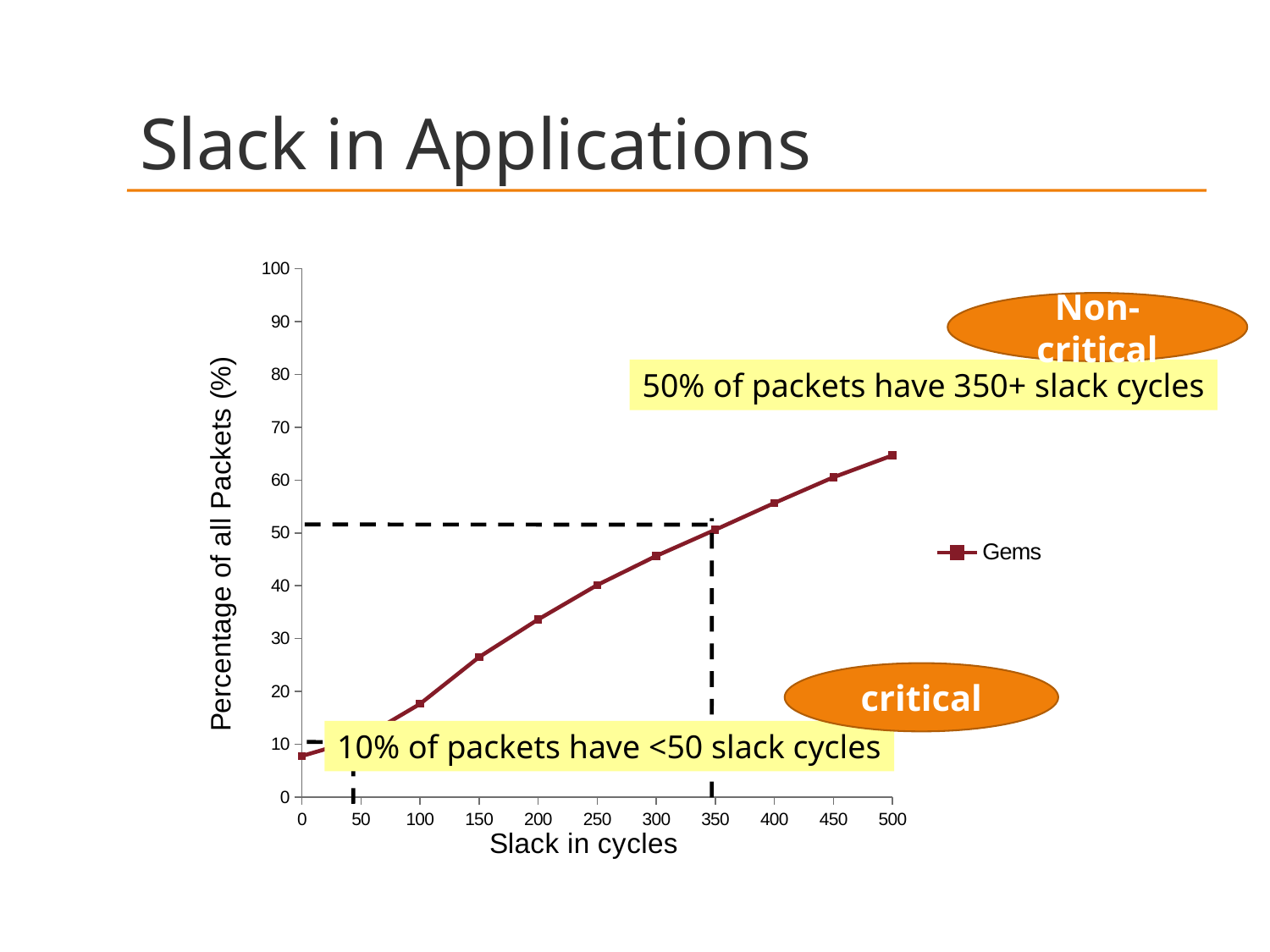
Is the value for Gems at 150 slack cycles greater or less than 30? less Is the value for Gems at 200 slack cycles greater or less than 30? greater Is the value for Gems at 500 slack cycles greater or less than 60? greater What is the name of the series shown in the legend? Gems At which slack value is the Gems series lowest? 0 Do the values of the Gems series rise or fall as slack in cycles increases? rise What kind of chart is shown on the slide? line chart At which slack value is the Gems series highest? 500 What is the title of the x axis? Slack in cycles How many series does the legend list? 1 Which is larger for Gems: the value at 400 slack cycles or the value at 250 slack cycles? 400 slack cycles